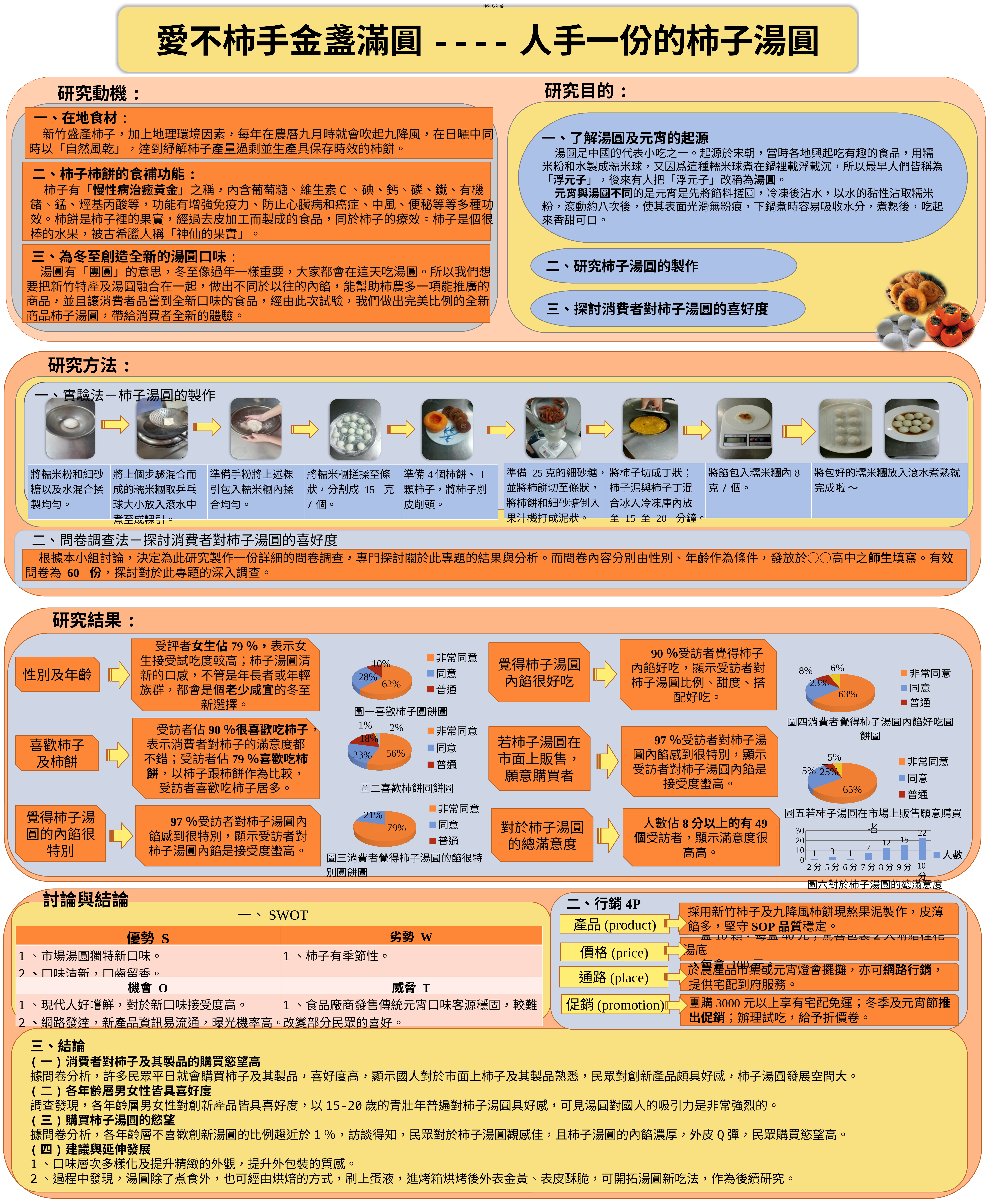
What kind of chart is 圖六對於柿子湯圓的總滿意度? bar chart In the chart titled 圖六對於柿子湯圓的總滿意度, what is the value for 10分? 22 In the chart titled 圖三消費者覺得柿子湯圓的餡很特別圓餅圖, what is the difference between the 非常同意 and 同意 slices? 58% In the chart titled 圖一喜歡柿子圓餅圖, what percentage is shown for 非常同意? 62% In the chart titled 圖一喜歡柿子圓餅圖, what percentage is shown for 普通? 10% In the chart titled 圖六對於柿子湯圓的總滿意度, how many score categories are shown on the x axis? 7 In the chart titled 圖六對於柿子湯圓的總滿意度, what is the difference between the values for 9分 and 8分? 3 In the chart titled 圖三消費者覺得柿子湯圓的餡很特別圓餅圖, what percentage is shown for 同意? 21% In the chart titled 圖二喜歡柿餅圓餅圖, what is the largest slice's percentage? 56% In the chart titled 圖四消費者覺得柿子湯圓內餡好吃圓餅圖, what percentage is shown for 非常同意? 63% In the chart titled 圖五若柿子湯圓在市場上販售願意購買者, what percentage is shown for 同意? 25% In the chart titled 圖六對於柿子湯圓的總滿意度, which score category has the lowest value? 2分 and 6分 (both 1)